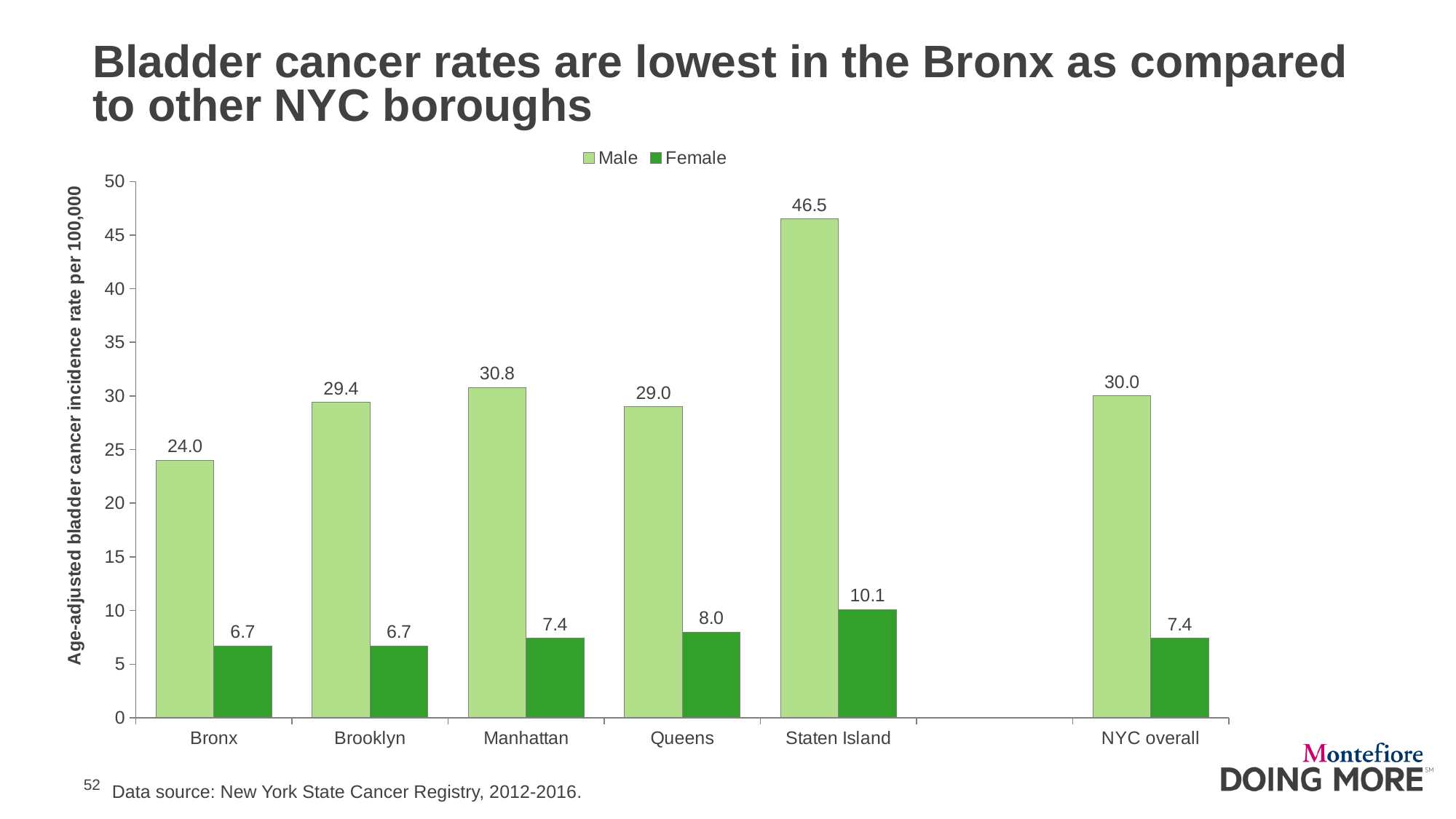
What is the Female bladder cancer incidence rate for Queens? 8.0 Which is larger, the Male rate for Manhattan or the Male rate for Brooklyn? Manhattan What is the Male rate for NYC overall? 30.0 What kind of chart is shown on the slide? Bar chart What is the Male bladder cancer incidence rate for Staten Island? 46.5 What is the label of the vertical axis? Age-adjusted bladder cancer incidence rate per 100,000 Which category has the highest Female rate? Staten Island Which category has the lowest Male rate? Bronx What is the difference between the Male rates for Staten Island and the Bronx? 22.5 How many categories are shown on the x axis? 6 Which category has the highest Male rate? Staten Island How many series does the legend list? 2